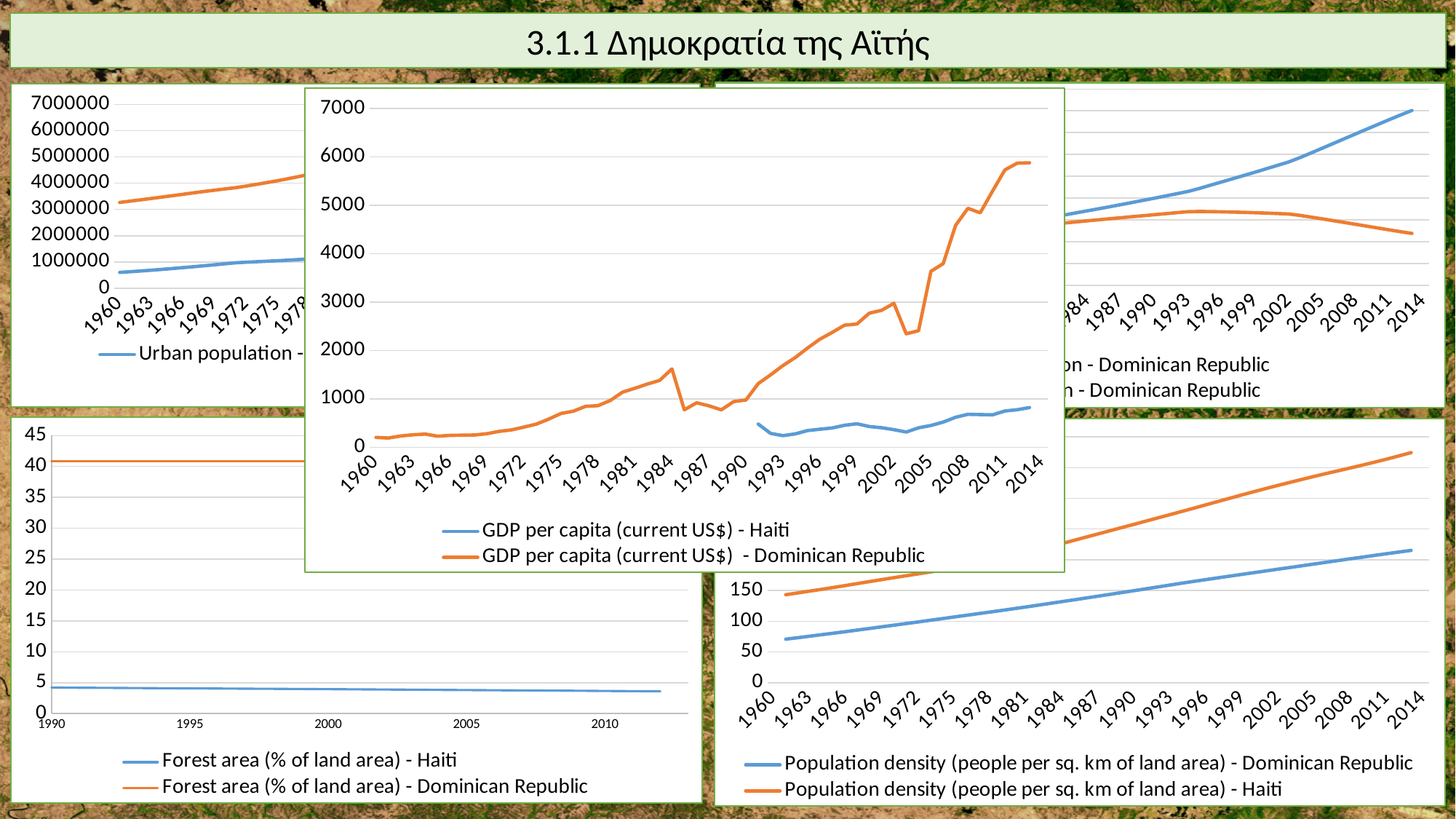
In the GDP per capita chart, is the value for Dominican Republic in 2014 greater or less than 5000? greater In the Population density chart at the bottom right, which country has the higher population density in 2014, Haiti or Dominican Republic? Haiti In the Forest area chart at the bottom left, is the value for Haiti in 2010 greater or less than 5? less In the GDP per capita chart, is the value for Haiti in 2014 greater or less than 1000? less What kind of chart is the GDP per capita chart in the centre of the slide? line chart In the Population density chart at the bottom right, does the Haiti series rise or fall from 1960 to 2014? rise In the GDP per capita chart, does the Dominican Republic series generally rise or fall from 1960 to 2014? rise How many series does the legend of the GDP per capita chart list? 2 In the Forest area chart at the bottom left, which country has the higher forest area, Haiti or Dominican Republic? Dominican Republic In the GDP per capita chart, which series is higher in 2014, Haiti or Dominican Republic? Dominican Republic